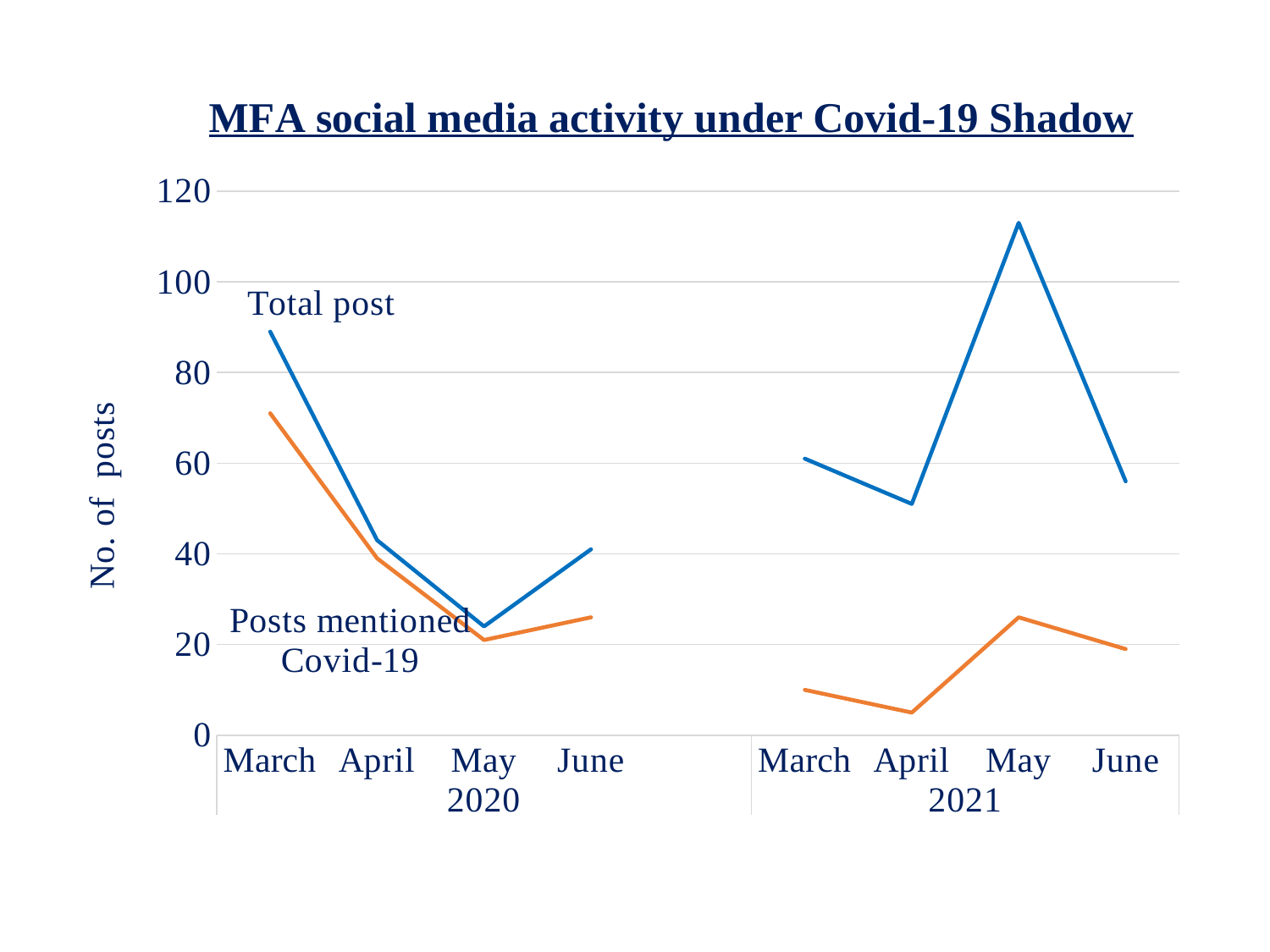
Is the Total post value for May 2021 greater or less than 100? greater Is the Total post value for March 2020 greater or less than 80? greater Which is larger, the Total post value for March 2020 or for March 2021? March 2020 In which month and year does the Total post series reach its highest value? May 2021 In which month and year is the Posts mentioned Covid-19 series lowest? April 2021 In which month and year does the Total post series reach its lowest value? May 2020 How many data series are plotted in the chart? 2 What is the label on the vertical axis of the chart? No. of posts What kind of chart is shown on the slide? Line chart In which month and year is the Posts mentioned Covid-19 series highest? March 2020 How many months (data points) are shown along the x axis in total? 8 Does the Total post series rise or fall from March 2020 to May 2020? Fall